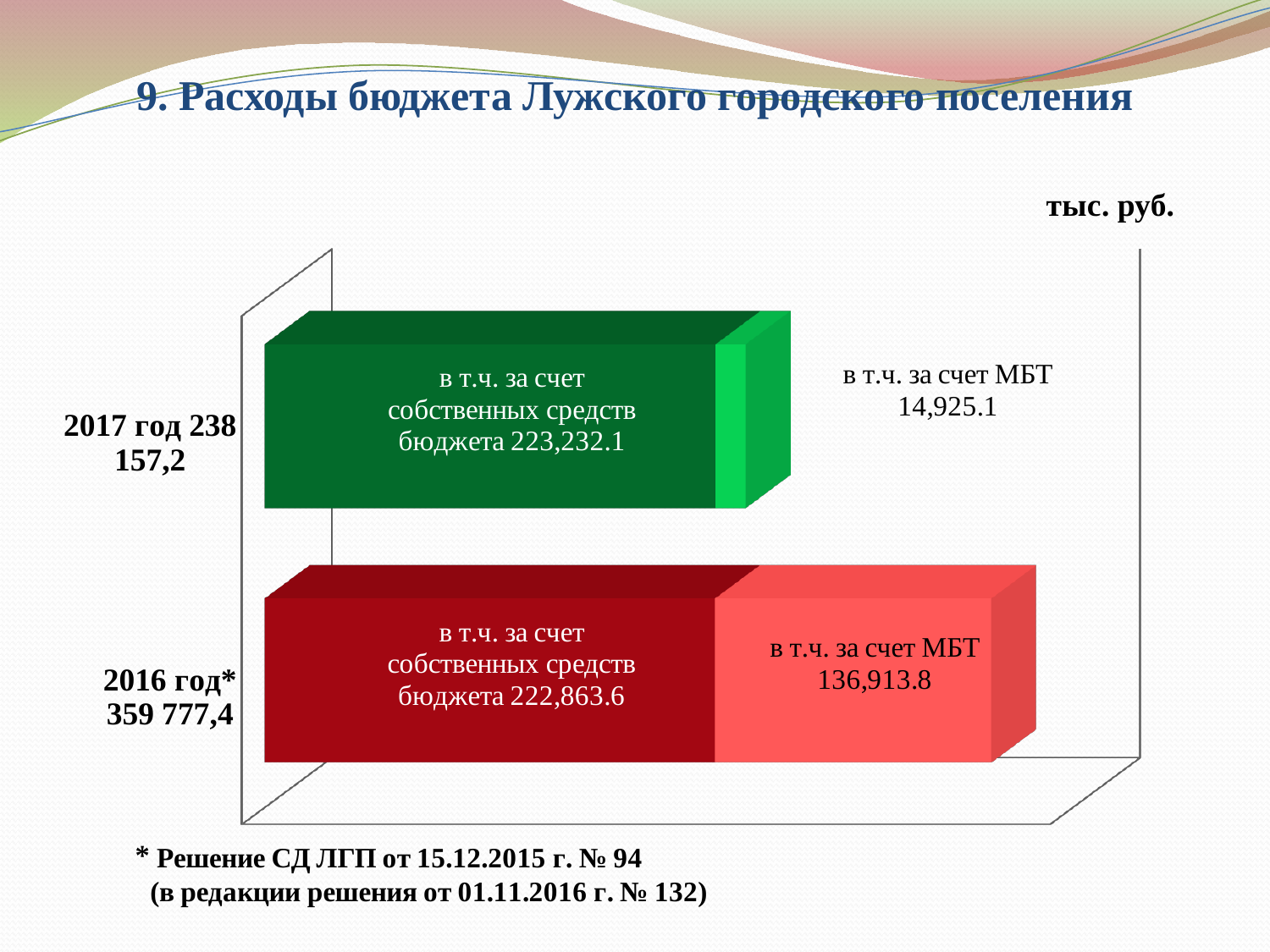
What is the value of own budget funds (собственные средства бюджета) for 2017? 223,232.1 What is the total budget expenditure shown for 2017? 238 157,2 Which year has the larger МБТ value, 2016 or 2017? 2016 What is the total budget expenditure shown for 2016? 359 777,4 Which year has the larger total budget expenditure? 2016 What is the difference between the own budget funds for 2017 and 2016? 368.5 How many years (categories) are shown in the chart? 2 What is the value of МБТ for 2016? 136,913.8 What type of chart is shown on the slide? Stacked bar chart What is the value of МБТ for 2017? 14,925.1 What is the value of own budget funds (собственные средства бюджета) for 2016? 222,863.6 What is the difference between the МБТ values for 2016 and 2017? 121,988.7